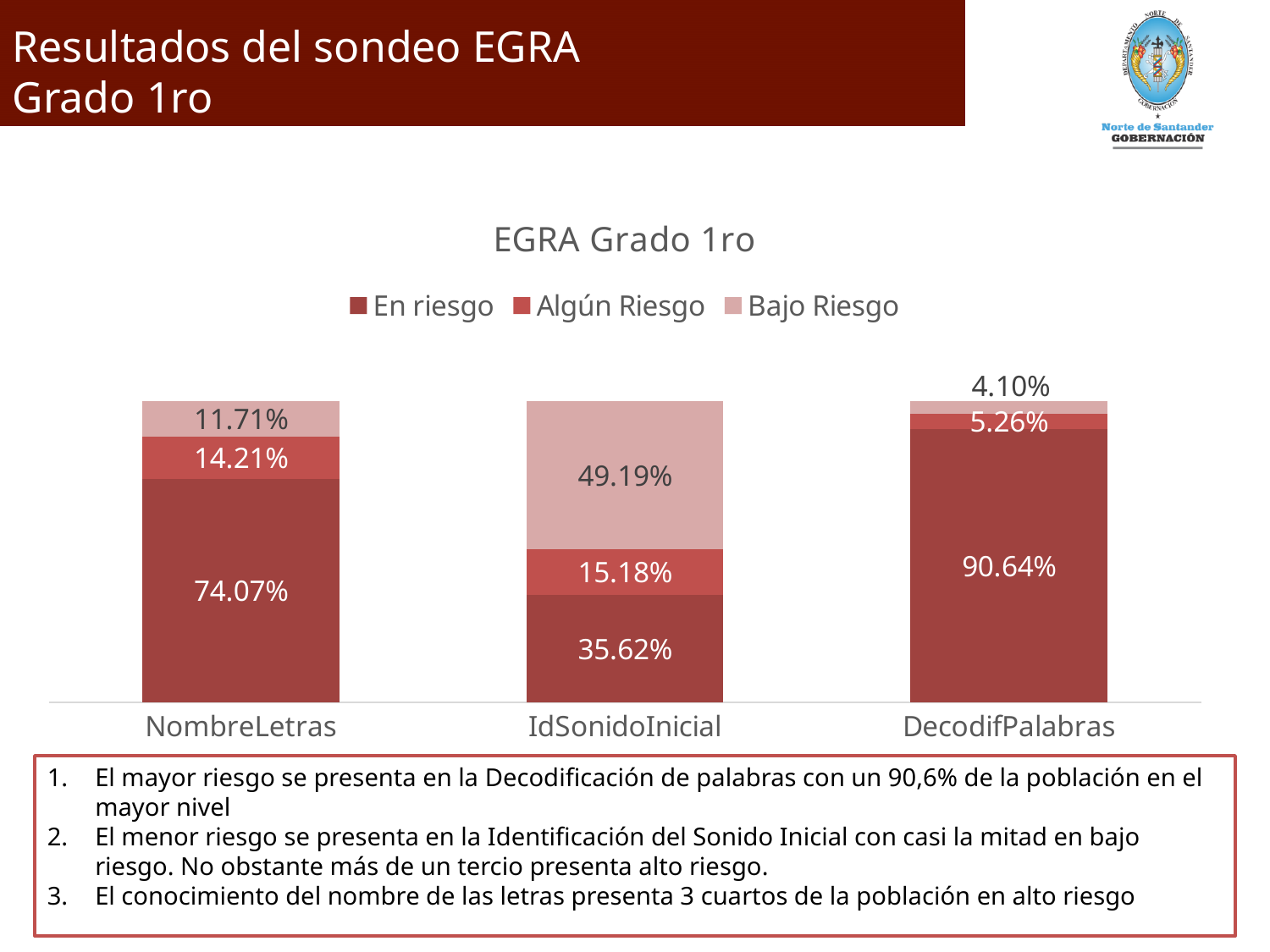
How many categories are shown on the x axis? 3 Which is larger: the Bajo Riesgo value for IdSonidoInicial or the Bajo Riesgo value for NombreLetras? IdSonidoInicial What is the difference between the En riesgo values for DecodifPalabras and NombreLetras? 16.57% What type of chart is shown on the slide? Stacked bar chart Which category has the lowest Bajo Riesgo value? DecodifPalabras How many series does the legend list? 3 Which category has the highest En riesgo value? DecodifPalabras What is the total of the stacked bar for DecodifPalabras? 100.00% What is the value of En riesgo for NombreLetras? 74.07% What is the value of Algún Riesgo for DecodifPalabras? 5.26% What is the value of Bajo Riesgo for IdSonidoInicial? 49.19% What is the title of the chart? EGRA Grado 1ro